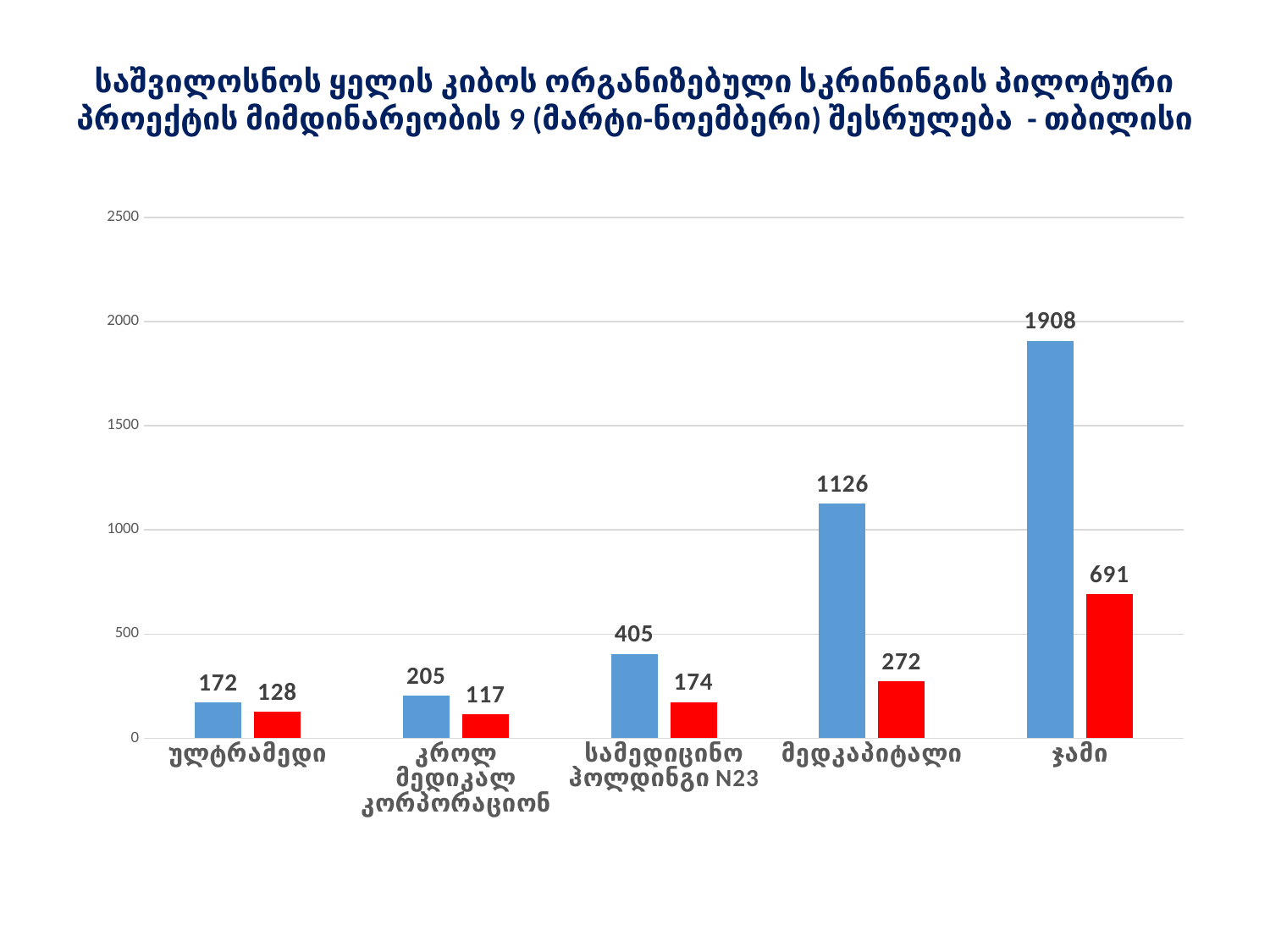
What is the difference between the blue and red bars for ჯამი? 1217 What is the value of the red bar for მედკაპიტალი? 272 What colours are the two series of bars in the chart? blue and red Is the blue bar for მედკაპიტალი greater or less than 1000? greater Which category has the lowest red bar? კროლ მედიკალ კორპორაციონ Which is larger, the blue bar for მედკაპიტალი or the blue bar for სამედიცინო ჰოლდინგი N23? მედკაპიტალი Which category has the highest blue bar? ჯამი What is the value of the blue bar for სამედიცინო ჰოლდინგი N23? 405 What is the value of the blue bar for ულტრამედი? 172 How many categories are shown on the x axis of the chart? 5 What type of chart is shown on the slide? bar chart What is the value of the red bar for კროლ მედიკალ კორპორაციონ? 117